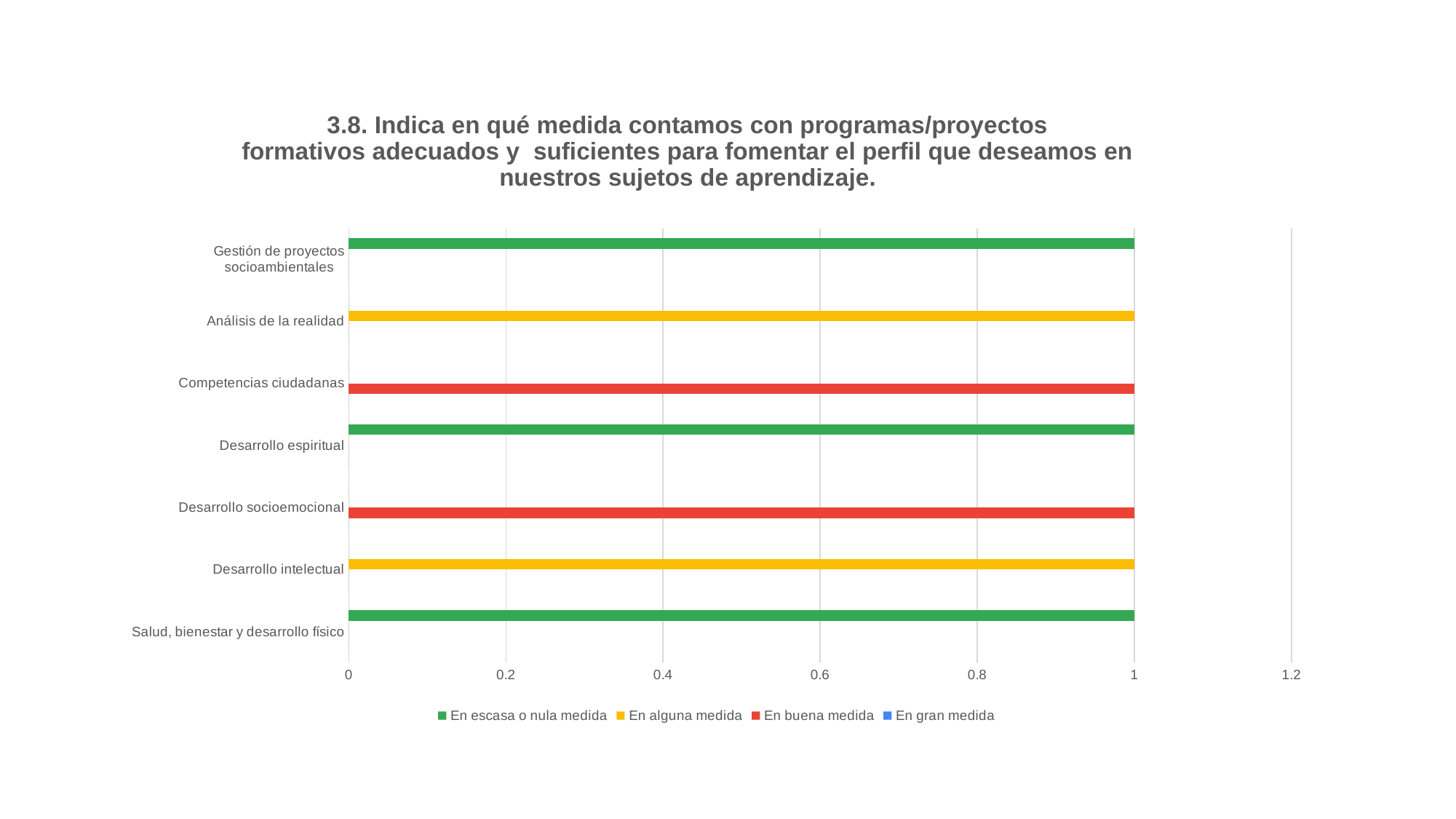
What is the value of the 'En escasa o nula medida' bar for 'Gestión de proyectos socioambientales'? 1 Which legend series is shown for 'Desarrollo intelectual'? En alguna medida Is the value for 'Desarrollo intelectual' greater or less than 1.2? less Is the value for 'Salud, bienestar y desarrollo físico' greater or less than 0.8? greater What is the value of the 'En buena medida' bar for 'Desarrollo socioemocional'? 1 Which legend series is shown for 'Desarrollo espiritual'? En escasa o nula medida What is the value of the 'En buena medida' bar for 'Competencias ciudadanas'? 1 What kind of chart is shown on the slide? bar chart How many categories are listed on the vertical axis of the chart? 7 What is the value of the 'En alguna medida' bar for 'Análisis de la realidad'? 1 How many series does the chart's legend list? 4 What is the difference between the value for 'Competencias ciudadanas' and the value for 'Desarrollo socioemocional'? 0